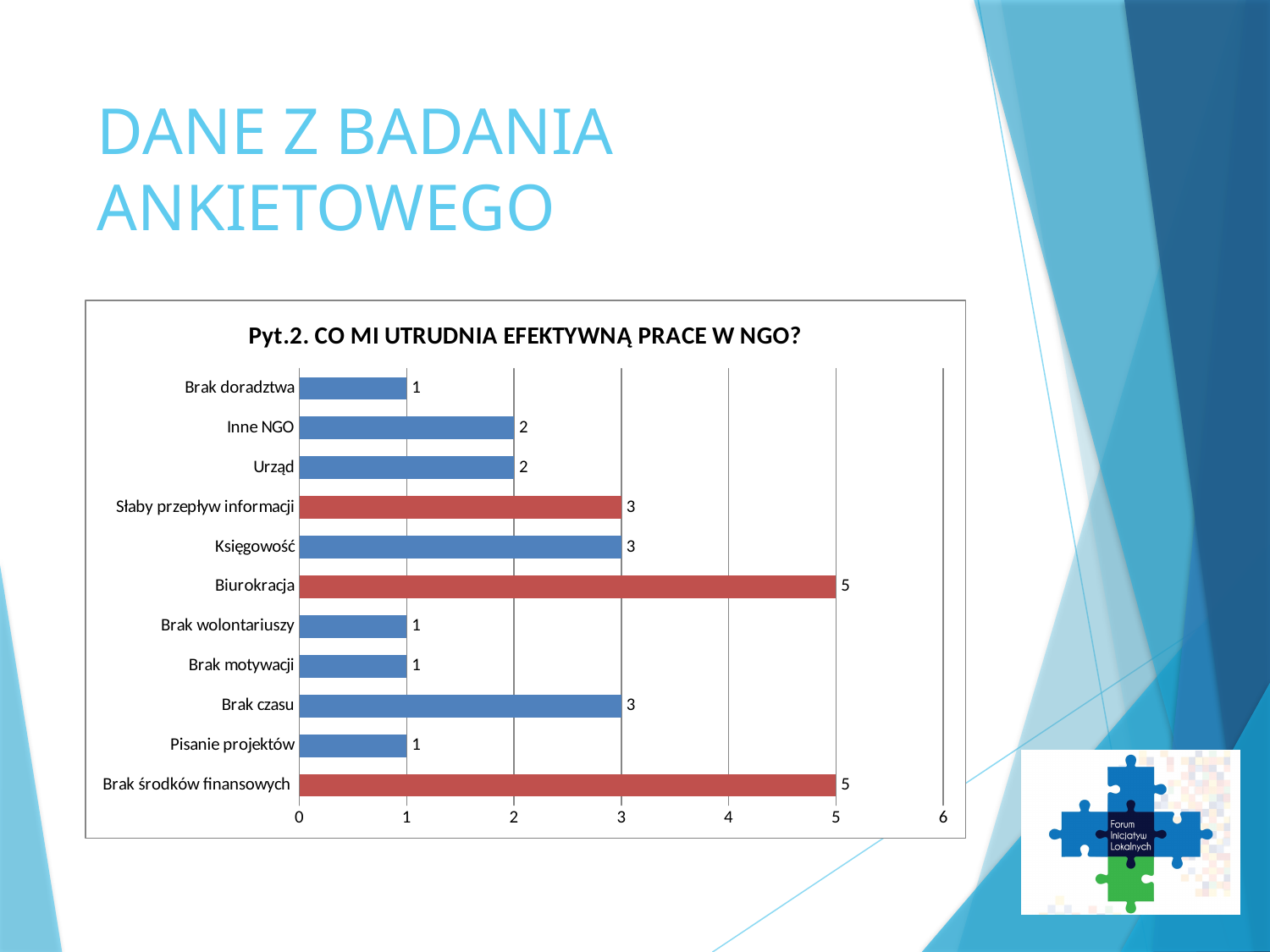
What type of chart is shown on the slide? bar chart How many categories have a value of 5? 2 Which categories are shown with red bars? Słaby przepływ informacji, Biurokracja, Brak środków finansowych How many categories are plotted in the chart? 11 What is the value for Księgowość? 3 What is the value for Brak środków finansowych? 5 What is the difference between the values for Biurokracja and Brak czasu? 2 What is the value for Biurokracja? 5 What is the title of the chart? Pyt.2. CO MI UTRUDNIA EFEKTYWNĄ PRACE W NGO? What is the value for Inne NGO? 2 Which is larger, the value for Urząd or the value for Słaby przepływ informacji? Słaby przepływ informacji What is the value for Pisanie projektów? 1